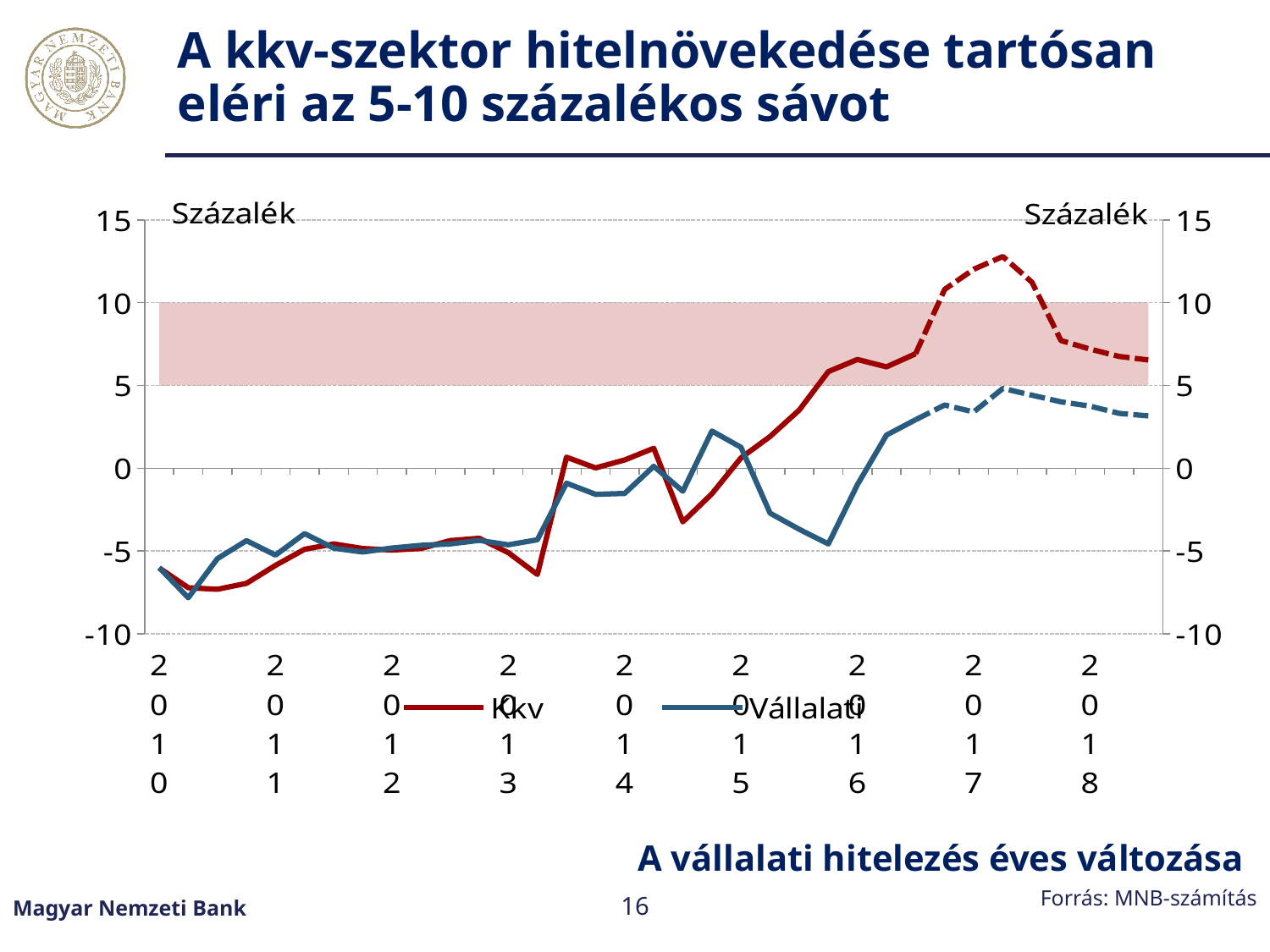
Is the value of the Kkv series at the start of the chart (2010) greater or less than -5? less How many series does the chart legend list? 2 Is the peak value of the Kkv series (dashed section, around 2017) greater or less than 10? greater Is the value of the Vállalati series at the right end of the chart greater or less than 5? less At the right end of the chart (2018), which series has the higher value, Kkv or Vállalati? Kkv Does the Vállalati series overall rise or fall from 2010 to 2018? rise How many year labels are shown along the x axis? 9 What are the two series named in the legend? Kkv and Vállalati What unit label is shown at the top of the vertical axes? Százalék What kind of chart is shown on the slide? line chart Does the Kkv series rise or fall between 2014 and its peak around 2017? rise